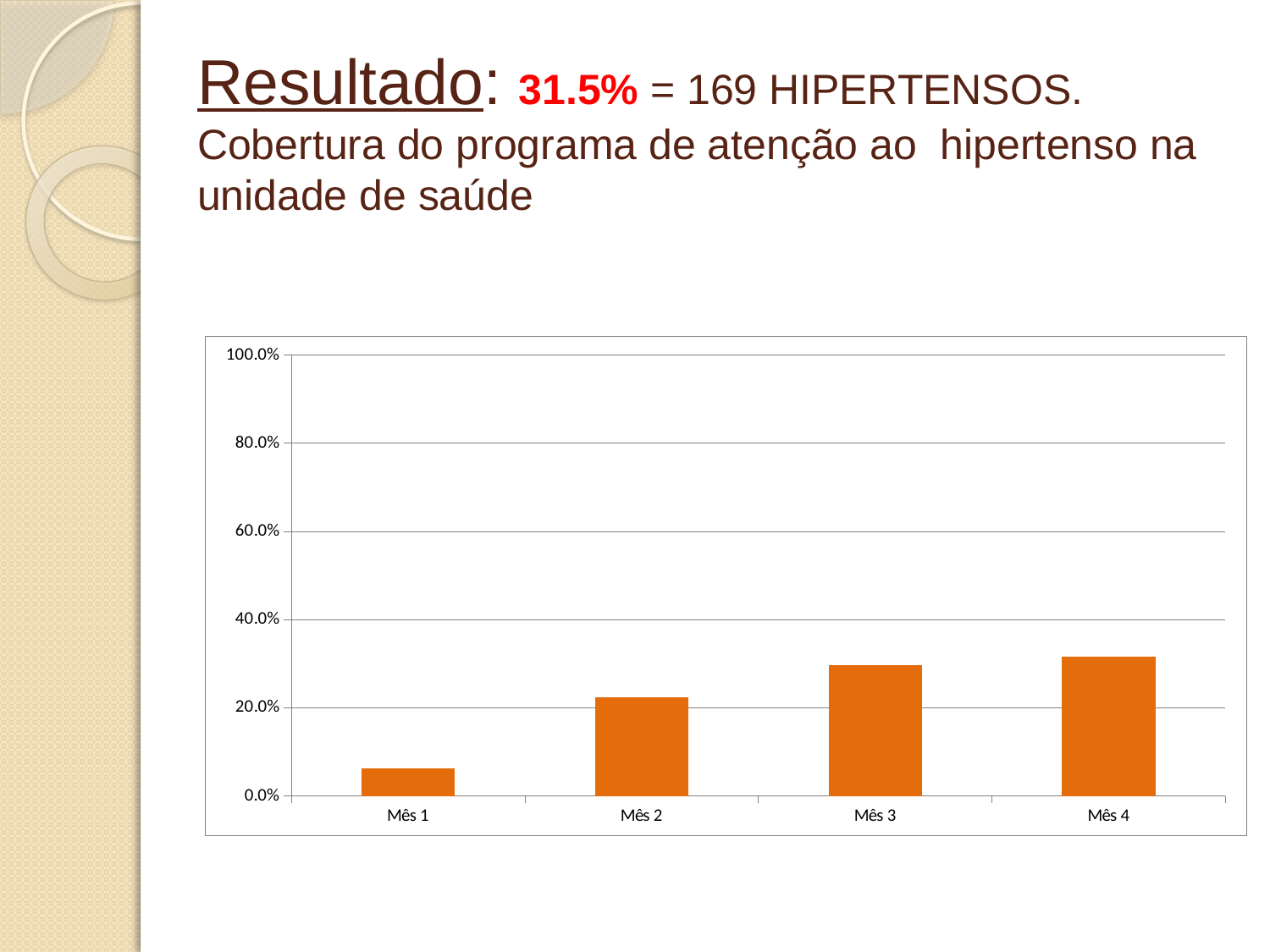
Is the value for Mês 3 greater or less than 40.0%? less Is the value for Mês 2 greater or less than 40.0%? less What kind of chart is shown on the slide? bar chart Which month has the lowest bar in the chart? Mês 1 What colour are the bars in the chart? orange How many categories (months) are shown on the x axis of the chart? 4 Is the value for Mês 4 greater or less than 20.0%? greater Do the values rise or fall from Mês 1 to Mês 4? rise Which is larger, the value for Mês 2 or the value for Mês 4? Mês 4 What is the highest value shown on the y axis of the chart? 100.0% Which is larger, the value for Mês 1 or the value for Mês 2? Mês 2